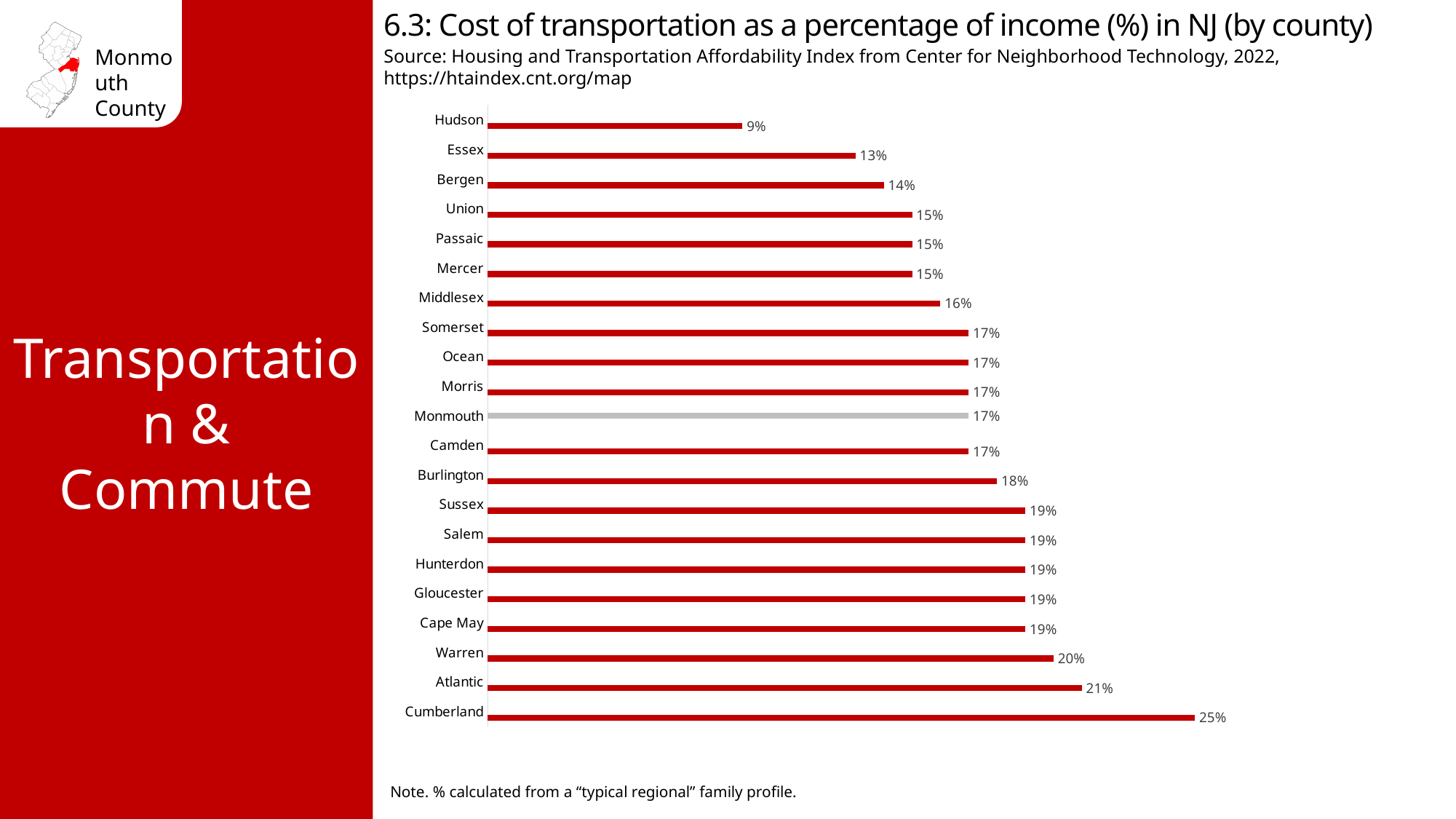
Which county's bar is shown in a different colour (grey) from the others? Monmouth How many counties are shown in the chart? 21 What is the cost of transportation as a percentage of income for Monmouth County? 17% What is the value shown for Cumberland County? 25% What is the difference between the values for Cumberland and Hudson? 16% What is the value shown for Atlantic County? 21% What is the value shown for Hudson County? 9% Which county has the lowest cost of transportation as a percentage of income? Hudson What type of chart is shown on the slide? Bar chart Which county has the highest cost of transportation as a percentage of income? Cumberland What is the difference between the values for Warren and Essex? 7% Which county has a larger value, Bergen or Burlington? Burlington